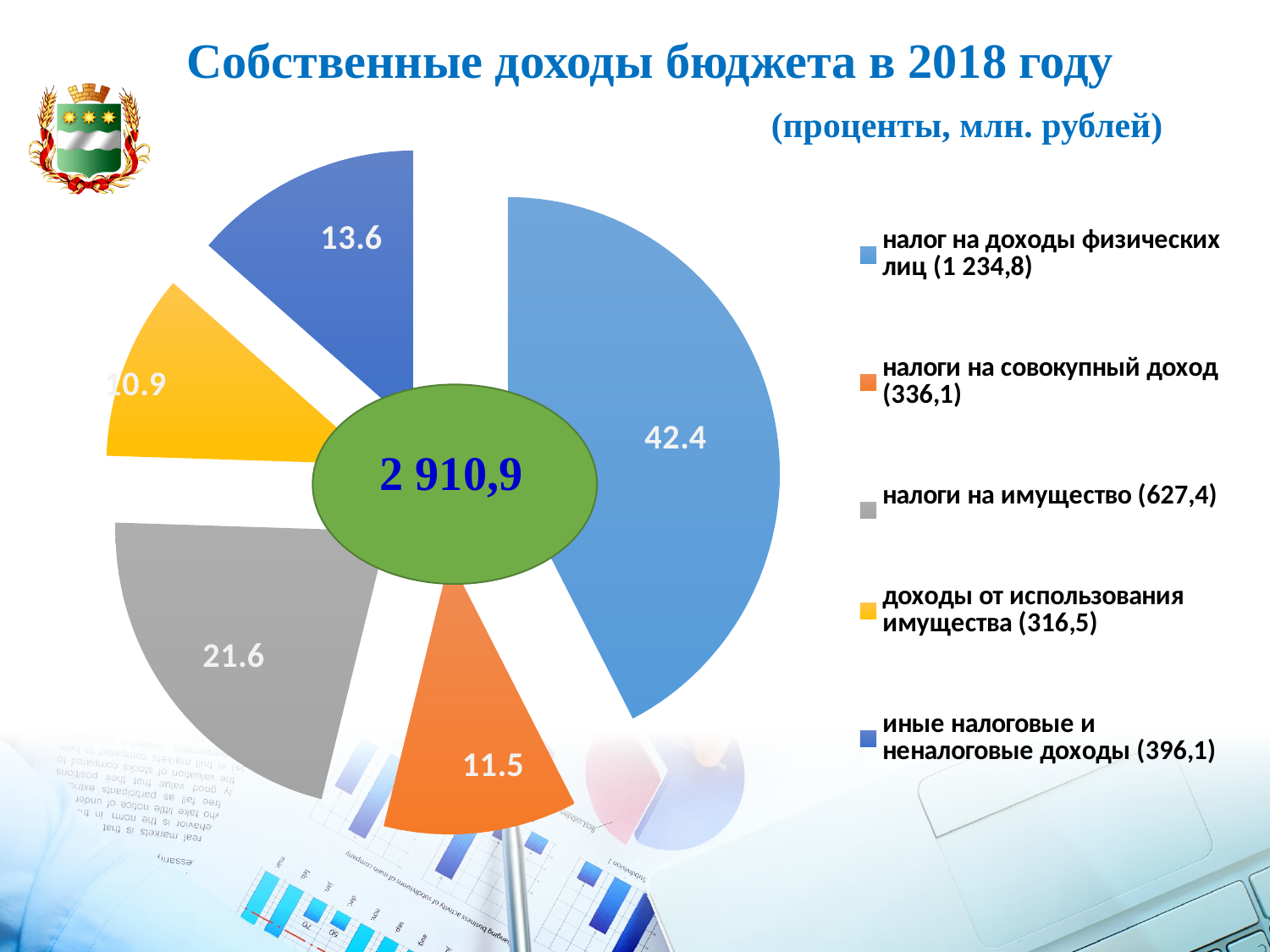
What percentage is shown for the slice 'доходы от использования имущества'? 10.9 What type of chart is shown on the slide? pie chart How many entries does the legend list? 5 What percentage is shown for the slice 'налоги на имущество'? 21.6 What percentage is shown for the slice 'налоги на совокупный доход'? 11.5 What percentage is shown for the slice 'налог на доходы физических лиц'? 42.4 What total value is shown in the centre of the pie chart? 2 910,9 Which category has the smallest share of the pie? доходы от использования имущества Which category has the largest share of the pie? налог на доходы физических лиц How many slices does the pie chart have? 5 Which is larger: the share for 'иные налоговые и неналоговые доходы' or for 'налоги на совокупный доход'? иные налоговые и неналоговые доходы What is the difference in percentage points between 'налог на доходы физических лиц' and 'налоги на имущество'? 20.8